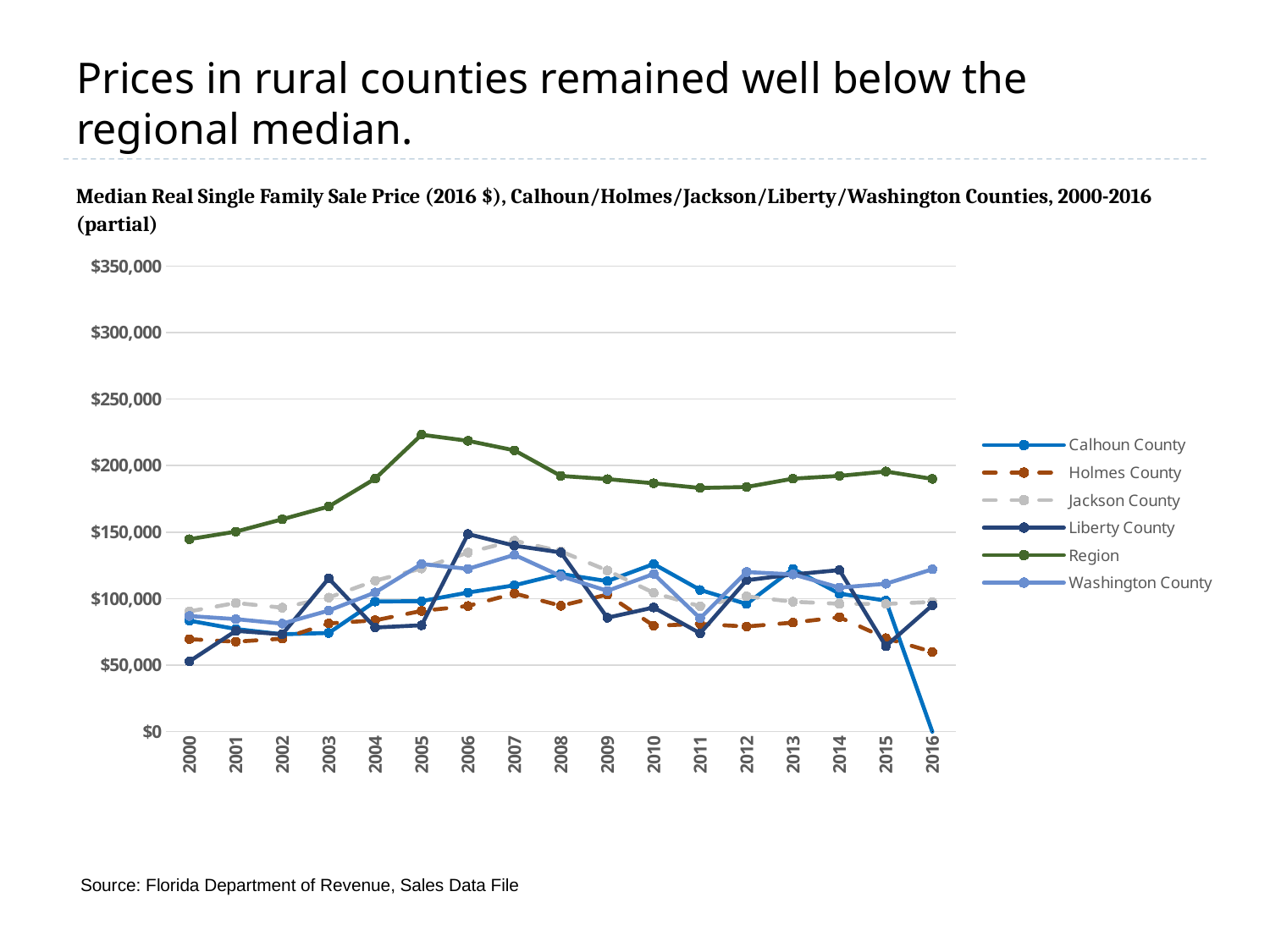
What source is cited for the chart data? Florida Department of Revenue, Sales Data File Which series has the lowest value in 2000? Liberty County Which series has the highest value in 2005? Region What kind of chart is shown on the slide? Line chart Does the Region series rise or fall from 2000 to 2005? Rises Is the value for Region in 2005 greater or less than $200,000? greater Is the value for Region in 2011 greater or less than $200,000? less How many years are plotted along the x axis? 17 Is the value for Liberty County in 2000 greater or less than $100,000? less How many series does the legend list? 6 In 2010, which is larger: the value for Region or the value for Holmes County? Region